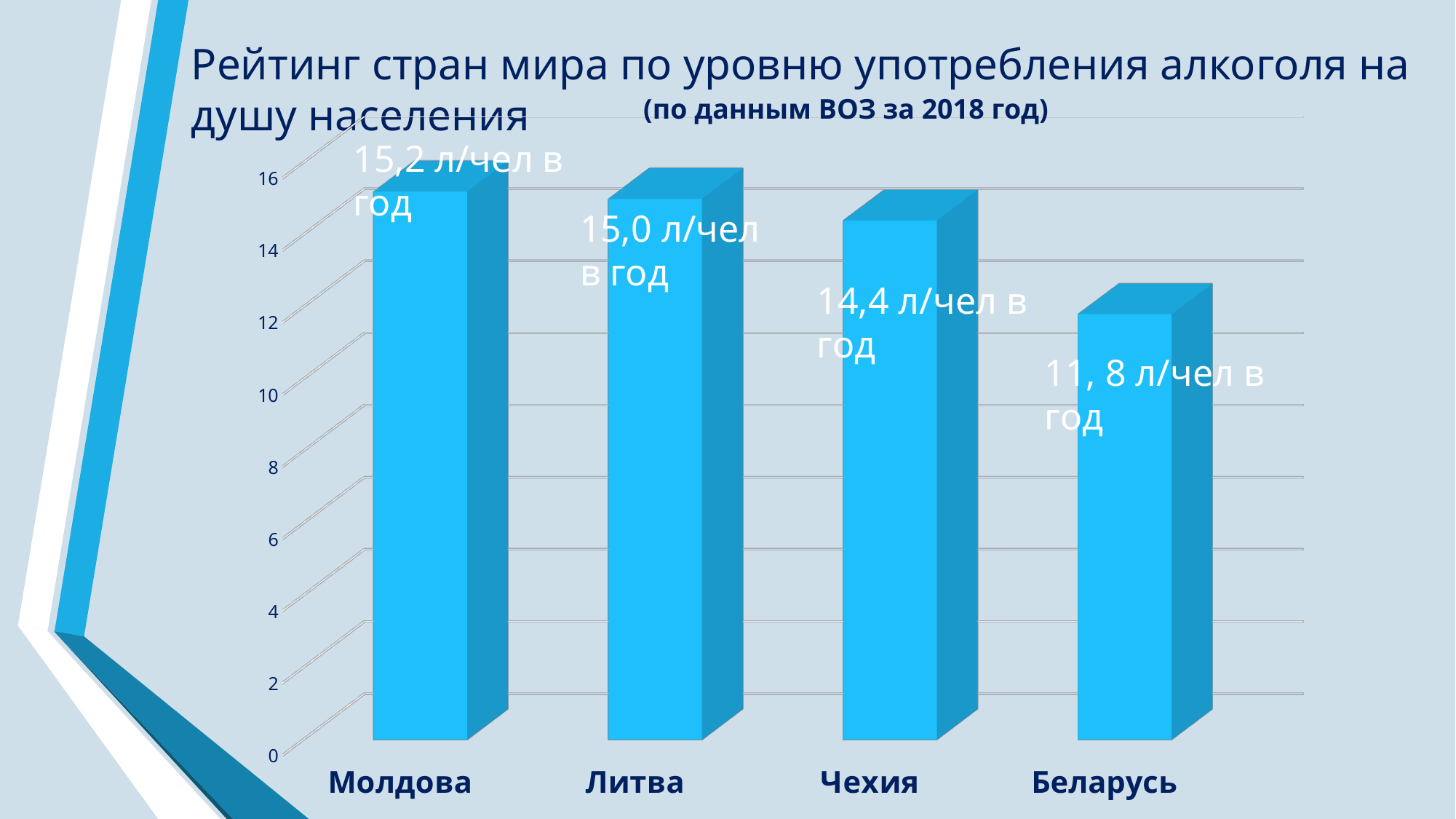
What is the difference between the values for Чехия and Беларусь? 2,6 л/чел в год Which is larger, the value for Чехия or the value for Беларусь? Чехия What is the value for Молдова? 15,2 л/чел в год Which country has the lowest value? Беларусь How many countries are shown in the chart? 4 Which country has the highest value? Молдова What kind of chart is shown on the slide? Bar chart Do the values rise or fall from left to right across the countries? Fall What is the value for Чехия? 14,4 л/чел в год What is the value for Литва? 15,0 л/чел в год What is the value for Беларусь? 11, 8 л/чел в год What is the difference between the values for Молдова and Беларусь? 3,4 л/чел в год